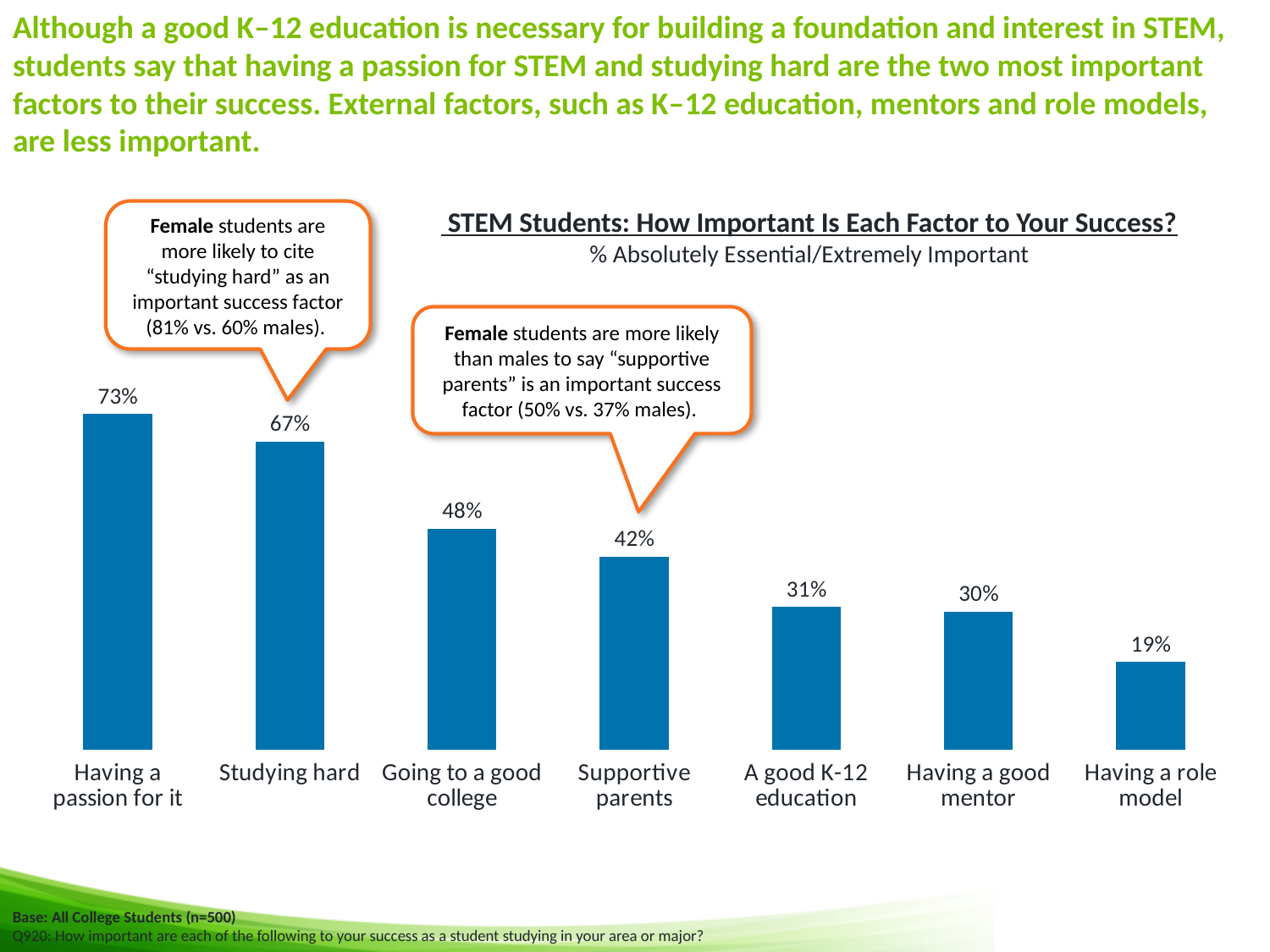
What is the value shown for 'Having a role model'? 19% Which factor has the highest percentage in the chart? Having a passion for it What is the title of the chart? STEM Students: How Important Is Each Factor to Your Success? What percentage of STEM students rated 'Having a passion for it' as absolutely essential/extremely important? 73% What is the difference in percentage points between 'Studying hard' and 'Going to a good college'? 19 What is the difference in percentage points between 'A good K-12 education' and 'Having a role model'? 12 How many factors are shown in the chart? 7 What is the value shown for 'Supportive parents'? 42% Which has a higher value: 'Going to a good college' or 'Supportive parents'? Going to a good college What type of chart is shown on the slide? Bar chart Do the values rise or fall moving from left to right across the chart? Fall Which factor has the lowest percentage in the chart? Having a role model